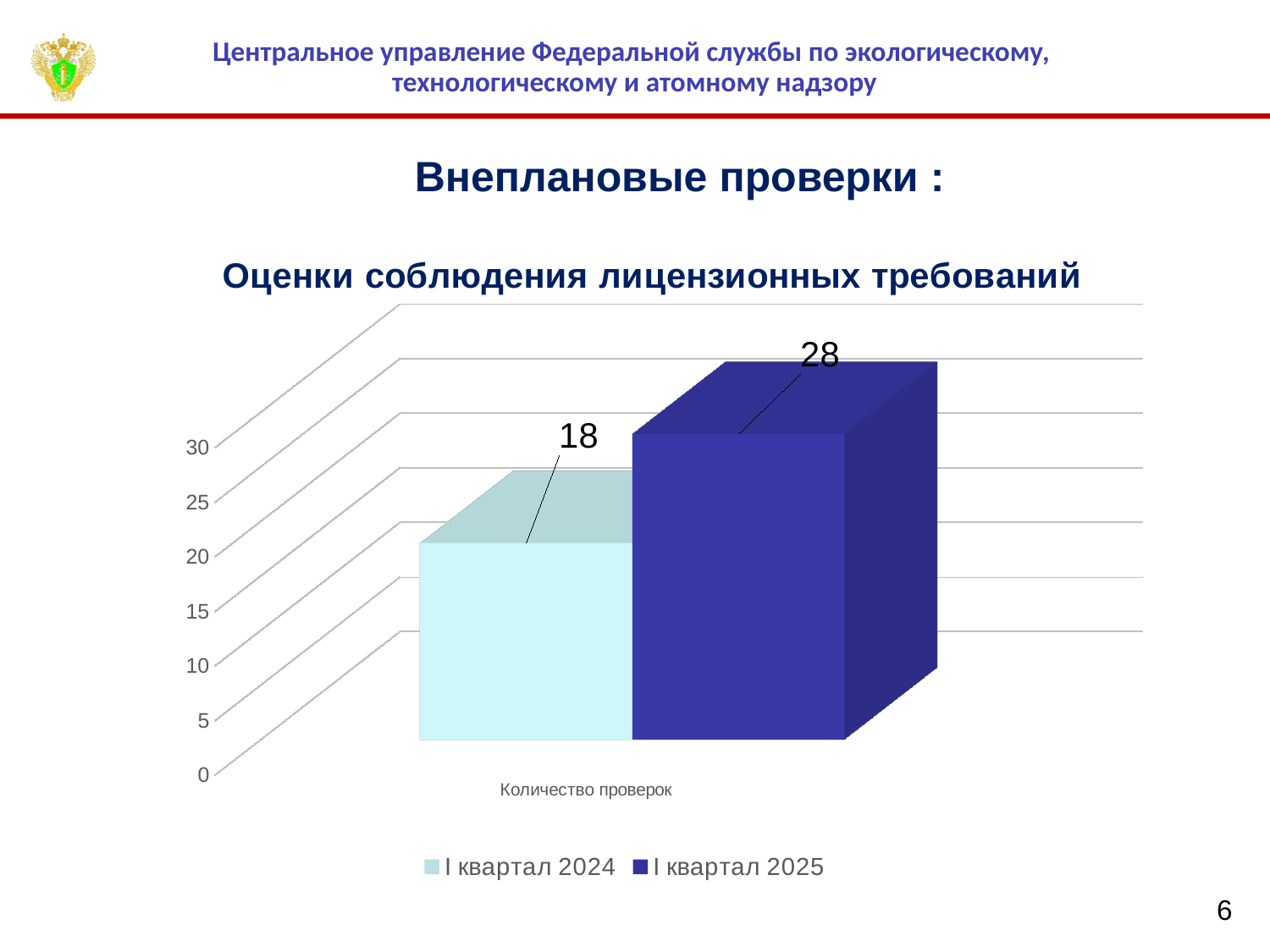
Is the value for I квартал 2024 greater or less than 20? less What is the value for I квартал 2024 in the chart? 18 How many series does the legend list? 2 What kind of chart is shown on the slide? Bar chart What is the title of the chart? Оценки соблюдения лицензионных требований Is the value for I квартал 2025 greater or less than 25? greater What is the value for I квартал 2025 in the chart? 28 Which series has the higher value, I квартал 2024 or I квартал 2025? I квартал 2025 How many categories are shown on the x axis of the chart? 1 What is the difference between the values for I квартал 2025 and I квартал 2024? 10 Which series has the lowest value in the chart? I квартал 2024 What is the category label shown on the x axis of the chart? Количество проверок